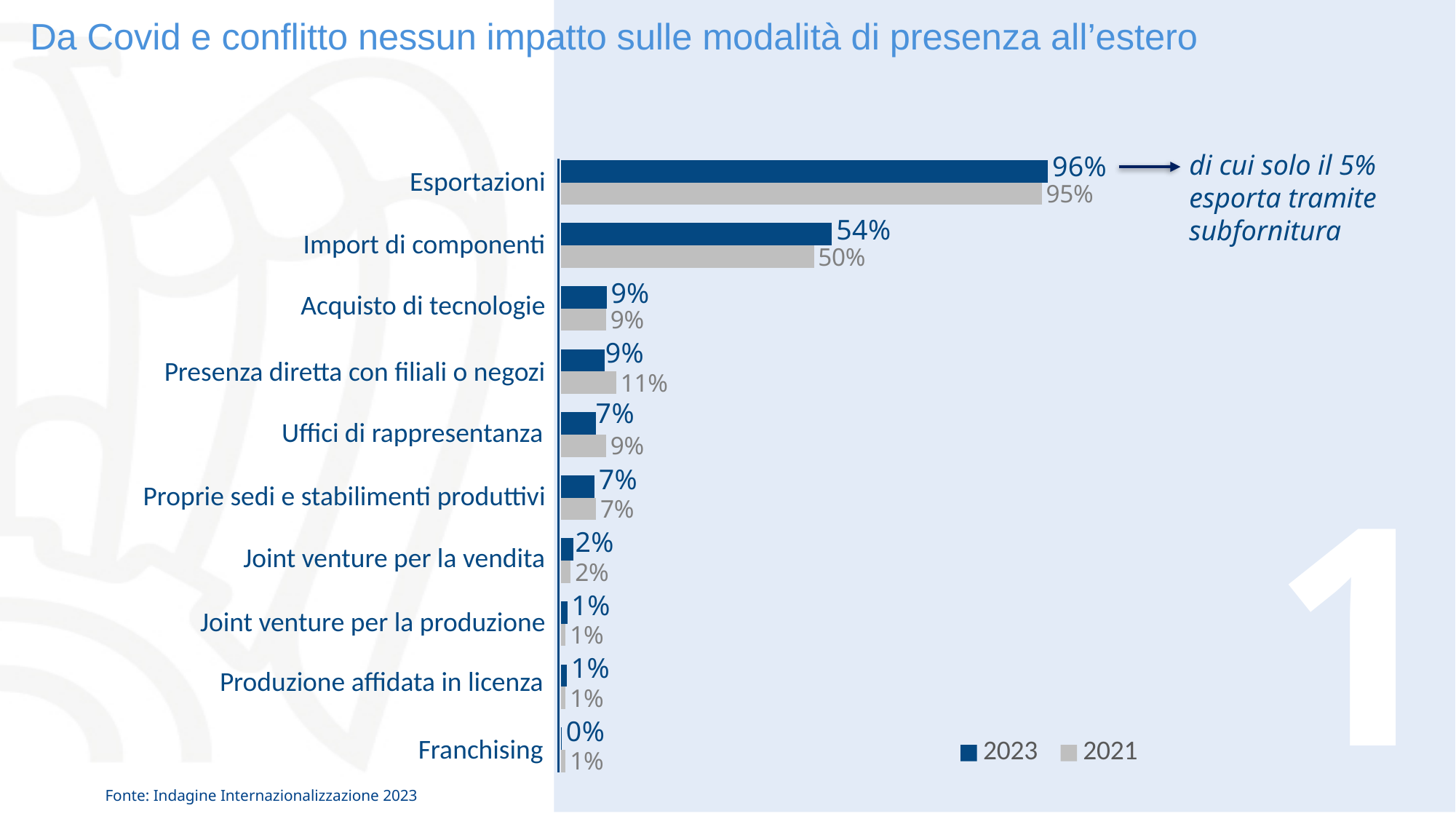
How many categories are shown on the chart? 10 What is the 2023 value for Esportazioni? 96% Which series is shown in dark blue according to the legend? 2023 What is the difference between the 2023 and 2021 values for Import di componenti? 4% What is the 2021 value for Presenza diretta con filiali o negozi? 11% What is the 2021 value for Import di componenti? 50% Which category has the highest 2023 value? Esportazioni What kind of chart is shown on the slide? Bar chart How many series does the legend list? 2 For Uffici di rappresentanza, which year has the larger value, 2023 or 2021? 2021 What is the 2023 value for Franchising? 0% Which category has the lowest 2023 value? Franchising